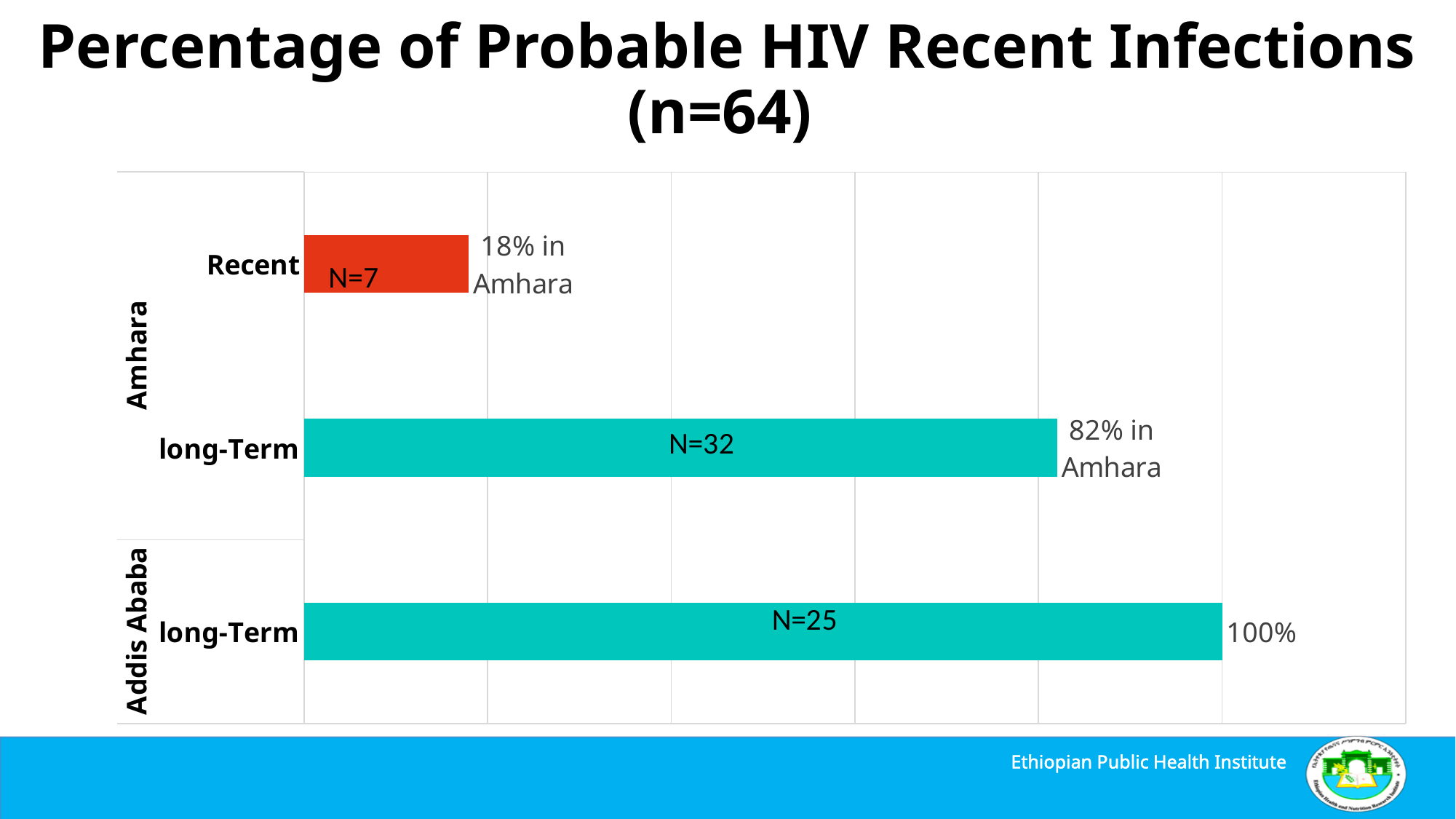
Which bar has the lowest percentage? Amhara Recent What is the N value labelled on the Recent bar for Amhara? N=7 What percentage is shown for Recent infections in Amhara? 18% How many bars are plotted in the chart? 3 What kind of chart is shown on the slide? Bar chart What is the N value labelled on the long-Term bar for Addis Ababa? N=25 Which is larger, the N for Amhara long-Term or the N for Addis Ababa long-Term? Amhara long-Term What is the N value labelled on the long-Term bar for Amhara? N=32 Which bar has the highest percentage? Addis Ababa long-Term What is the difference in percentage points between long-Term and Recent infections in Amhara? 64 What percentage is shown for long-Term infections in Amhara? 82% What percentage is shown for long-Term infections in Addis Ababa? 100%